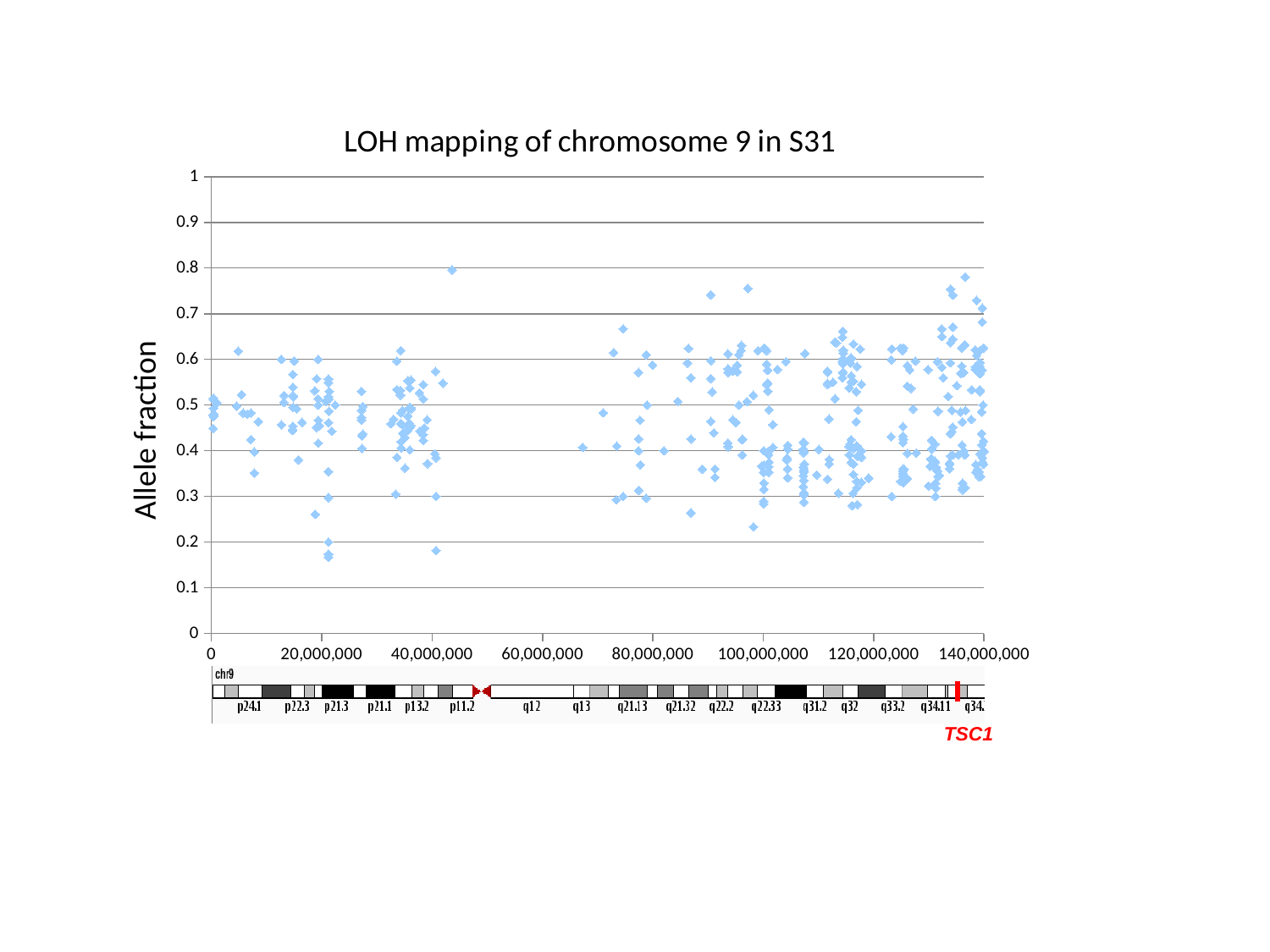
Are there any points plotted between 50,000,000 and 60,000,000 on the x axis? No What is the label of the y axis? Allele fraction What is the title of the chart? LOH mapping of chromosome 9 in S31 Is the highest allele fraction value plotted greater or less than 0.9? less Is the highest allele fraction value plotted greater or less than 0.7? greater Is the lowest allele fraction value plotted greater or less than 0.1? greater What kind of chart is shown on the slide? scatter plot